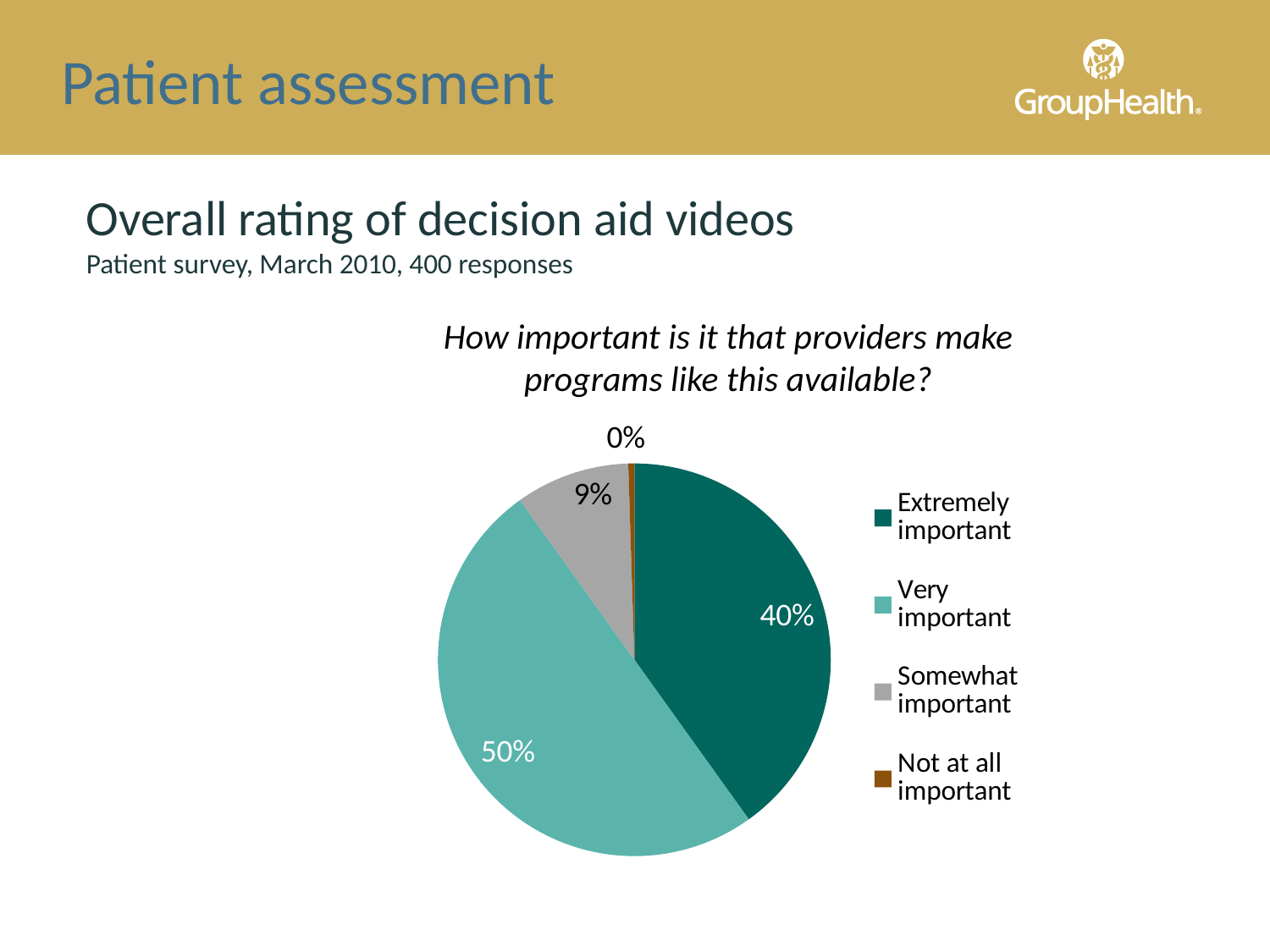
What kind of chart is shown on the slide? Pie chart What share of the pie is labelled "Very important"? 50% Which category has the smallest slice of the pie? Not at all important What share of the pie is labelled "Extremely important"? 40% How many categories does the legend list? 4 What colour is the "Somewhat important" slice? Grey What question is the chart titled with? How important is it that providers make programs like this available? What is the difference in percentage points between the "Very important" and "Extremely important" slices? 10 Which slice is larger, "Extremely important" or "Somewhat important"? Extremely important Which category has the largest slice of the pie? Very important What share of the pie is labelled "Somewhat important"? 9% What share of the pie is labelled "Not at all important"? 0%